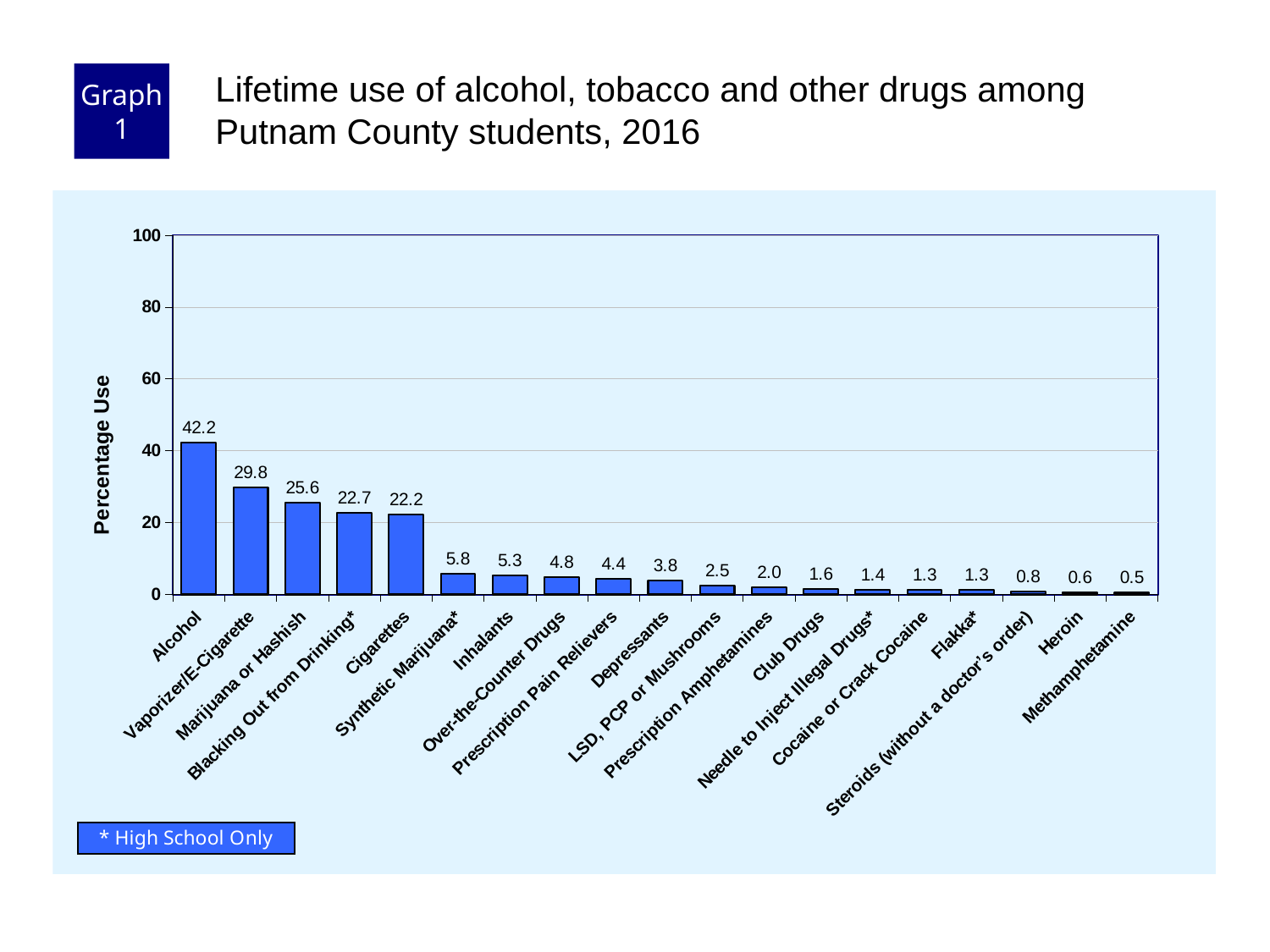
What is the label of the y axis? Percentage Use Which has a higher percentage use, Marijuana or Hashish or Blacking Out from Drinking*? Marijuana or Hashish Which category has the lowest percentage use? Methamphetamine How many categories are shown on the x axis? 19 Which category has the highest percentage use? Alcohol What is the percentage use for Alcohol? 42.2 What is the percentage use for Vaporizer/E-Cigarette? 29.8 What is the percentage use for Inhalants? 5.3 Is the value for Vaporizer/E-Cigarette greater or less than 20? greater What is the percentage use for Heroin? 0.6 What is the difference in percentage use between Alcohol and Cigarettes? 20.0 What kind of chart is shown on the slide? Bar chart